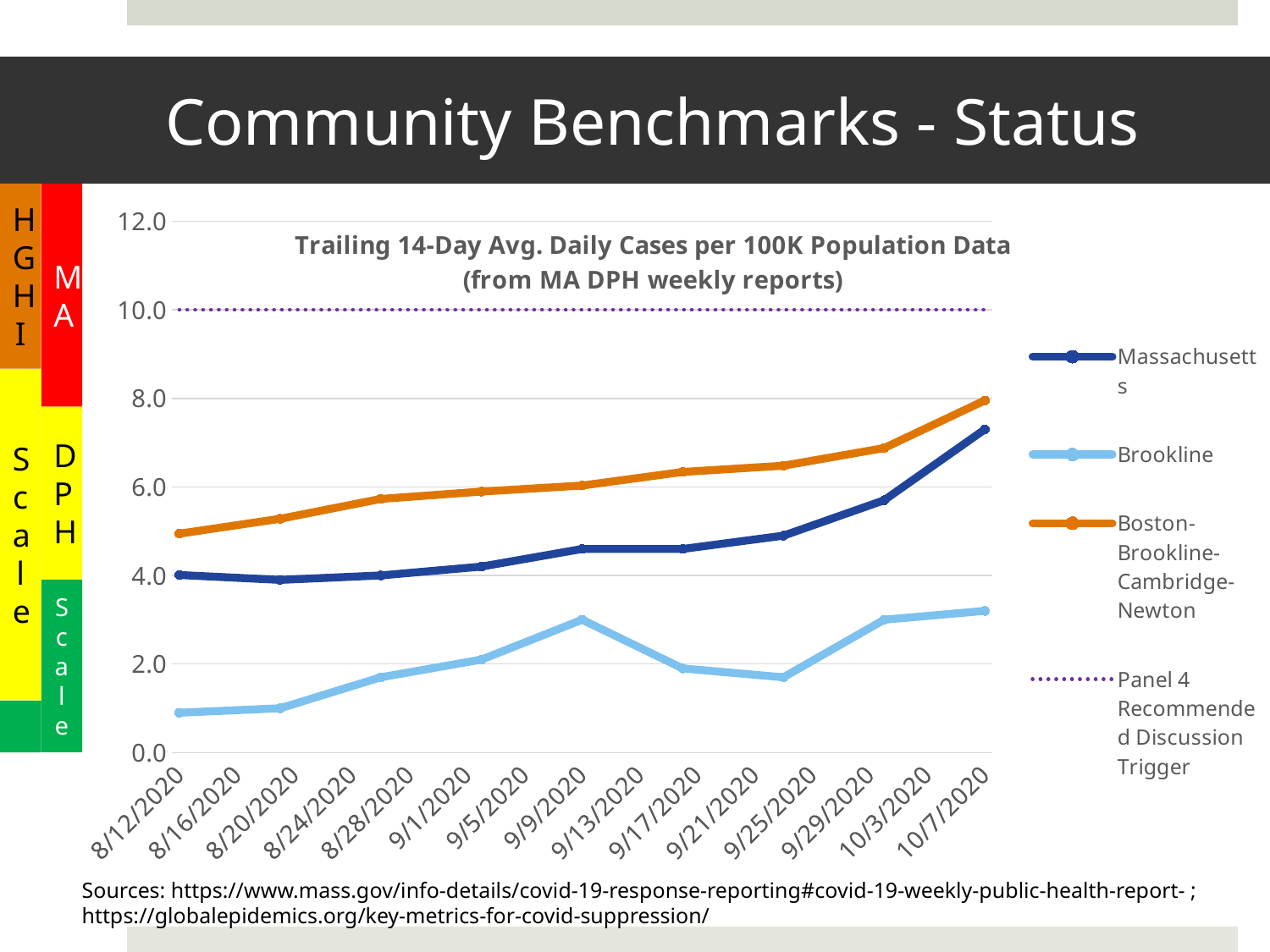
What value does the Panel 4 Recommended Discussion Trigger line sit at? 10.0 Is the value for Brookline on 10/7/2020 greater or less than 4.0? less How many dates are shown along the x axis of the chart? 15 Does the Massachusetts line rise or fall from 8/12/2020 to 10/7/2020? rise Which of the three plotted communities has the lowest value on 10/7/2020? Brookline Is the value for Boston-Brookline-Cambridge-Newton on 8/12/2020 greater or less than 6.0? less Is the value for Brookline on 8/12/2020 greater or less than 2.0? less How many series does the chart legend list? 4 What kind of chart is shown on the slide? line chart What is the title of the chart? Trailing 14-Day Avg. Daily Cases per 100K Population Data (from MA DPH weekly reports) On 9/9/2020, which is higher: Boston-Brookline-Cambridge-Newton or Brookline? Boston-Brookline-Cambridge-Newton